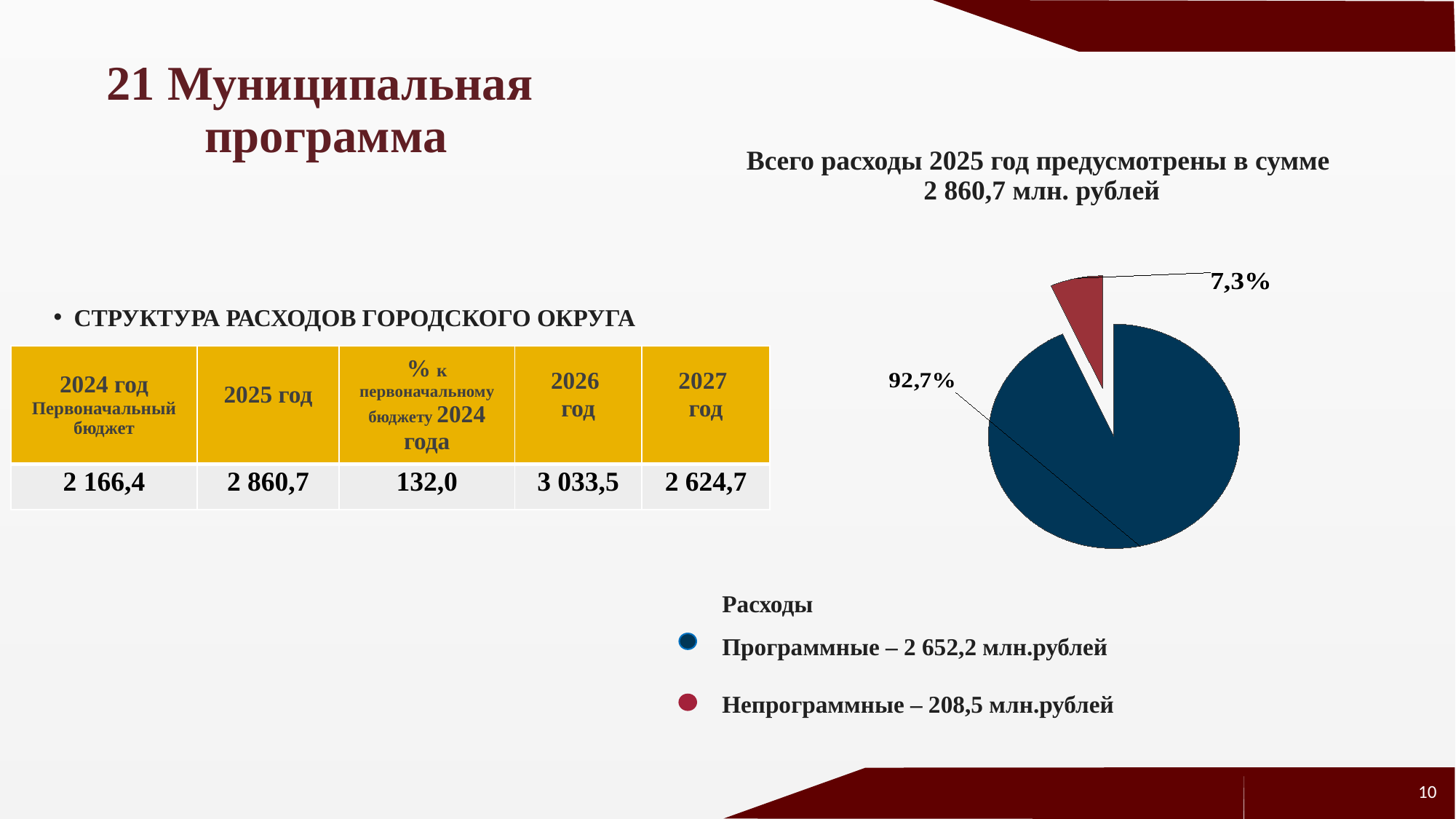
Which slice of the pie chart is the largest? Программные What kind of chart is shown on the slide? Pie chart What is the difference in percentage points between the "Программные" and "Непрограммные" slices? 85,4 According to the legend, what is the value for "Непрограммные" expenses? 208,5 млн.рублей How many entries does the pie chart legend list? 2 What colour is the "Непрограммные" slice in the pie chart? Red Which is larger in the pie chart: "Программные" or "Непрограммные"? Программные What share of the pie chart does the "Непрограммные" slice represent? 7,3% Which slice of the pie chart is the smallest? Непрограммные What share of the pie chart does the "Программные" slice represent? 92,7% How many slices does the pie chart have? 2 According to the legend, what is the value for "Программные" expenses? 2 652,2 млн.рублей